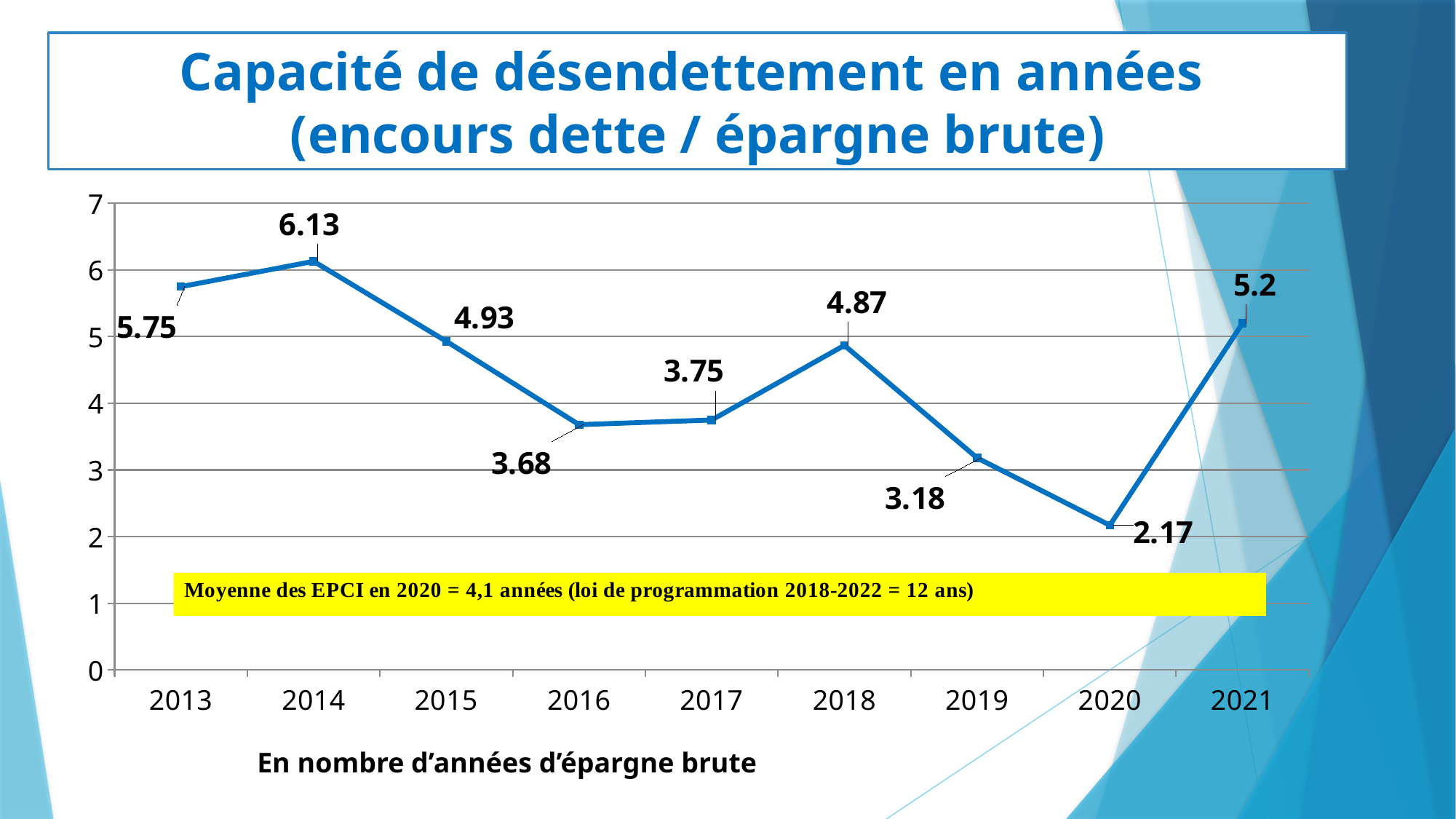
What is the value for 2017? 3.75 Does the value rise or fall from 2018 to 2020? fall Is the value for 2019 greater or less than 3? greater Which year has the lowest value? 2020 Which is larger, the value for 2015 or the value for 2018? 2015 What is the title of the chart? Capacité de désendettement en années (encours dette / épargne brute) What is the difference between the values for 2021 and 2020? 3.03 How many years are plotted on the x axis? 9 What is the value for 2014? 6.13 Which year has the highest value? 2014 What is the value for 2020? 2.17 What kind of chart is shown? line chart